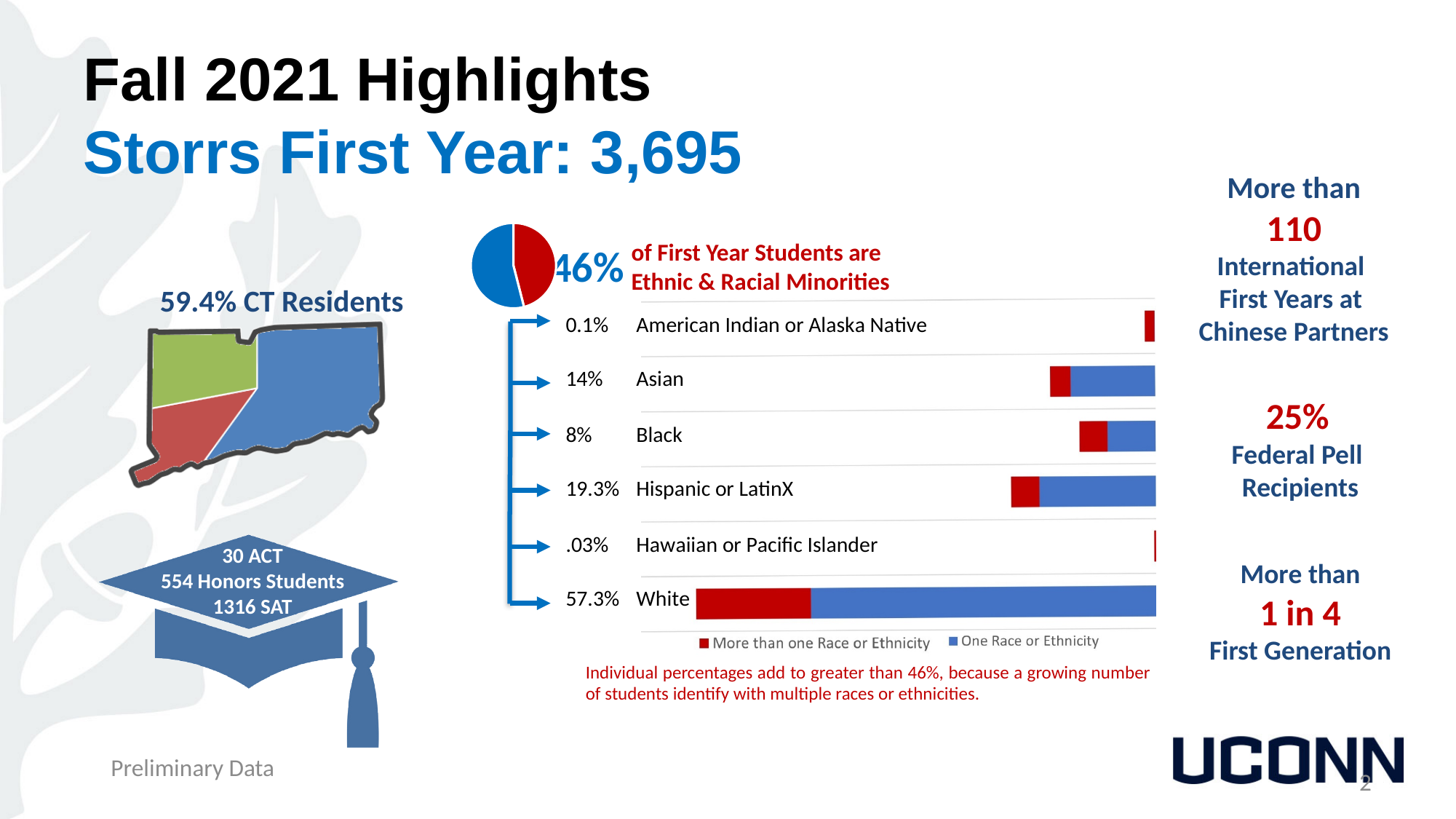
In the race and ethnicity bar chart, what percentage is shown for Black? 8% In the race and ethnicity bar chart, what percentage is shown for Hispanic or LatinX? 19.3% According to the pie chart, what percentage of first year students are ethnic and racial minorities? 46% In the race and ethnicity bar chart, which category has the lowest percentage? Hawaiian or Pacific Islander In the race and ethnicity bar chart, how many categories are listed? 6 In the race and ethnicity bar chart, which is larger, the percentage for Asian or the percentage for Black? Asian In the race and ethnicity bar chart, what percentage is shown for Asian? 14% In the race and ethnicity bar chart, what percentage is shown for White? 57.3% What kind of chart shows the race and ethnicity breakdown of first year students? bar chart In the race and ethnicity bar chart, which category has the highest percentage? White In the race and ethnicity bar chart, what is the difference between the percentages for Hispanic or LatinX and Asian? 5.3% In the race and ethnicity bar chart, how many series does the legend list? 2